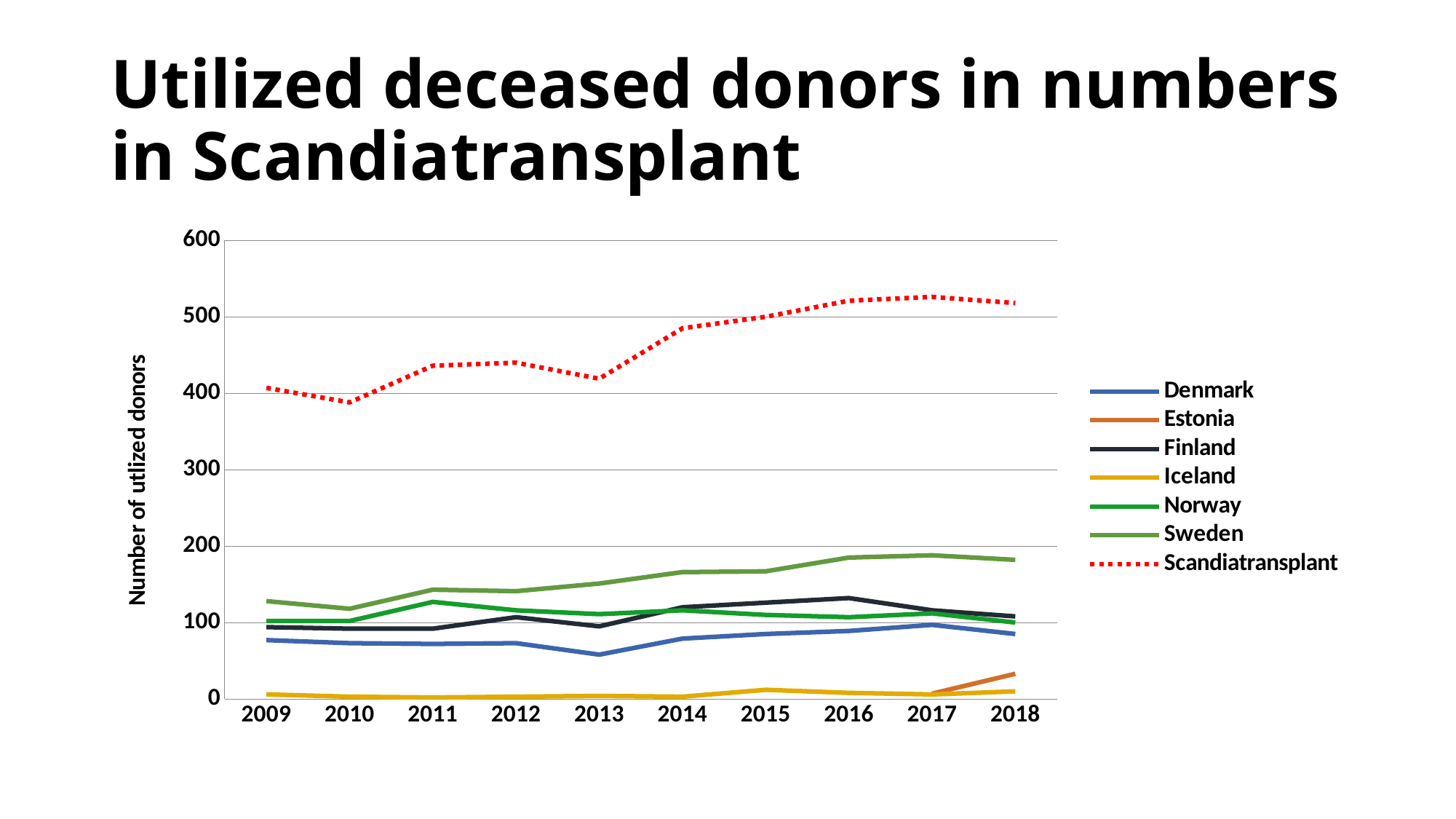
Which series has the highest values across all years? Scandiatransplant In 2016, which is larger, the value for Finland or the value for Norway? Finland Is the value for Scandiatransplant in 2014 greater or less than 500? less Do the values for Scandiatransplant rise or fall from 2013 to 2017? rise How many series does the legend list? 7 What kind of chart is shown on the slide? line chart Which series is drawn with a dotted line? Scandiatransplant Is the value for Sweden in 2018 greater or less than 200? less How many years are shown on the x axis? 10 Is the value for Scandiatransplant in 2018 greater or less than 500? greater Which series has the lowest value in 2009? Iceland